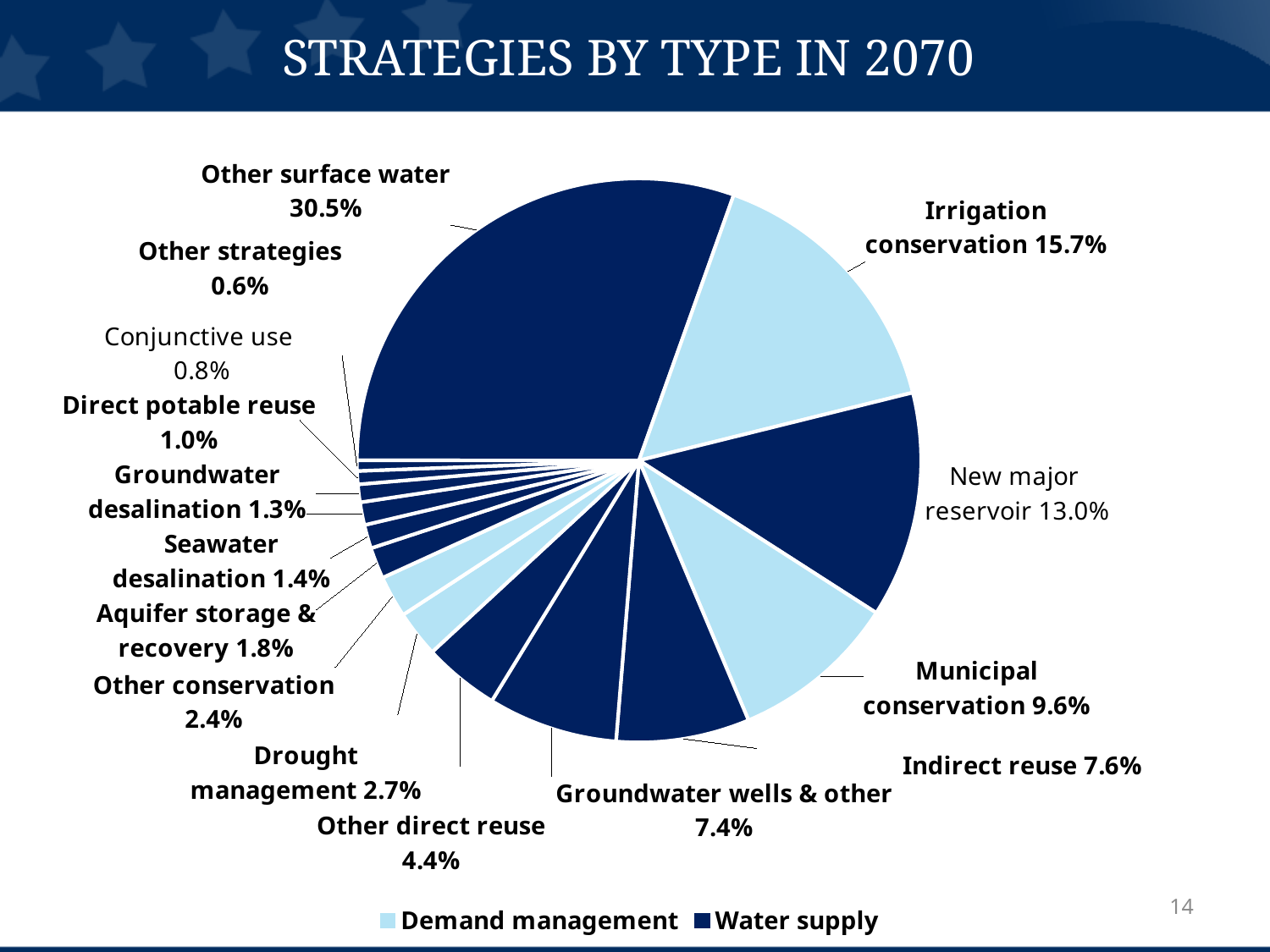
Which strategy type has the smallest slice of the pie? Other strategies What is the value shown for Irrigation conservation? 15.7% What is the title of the chart on the slide? STRATEGIES BY TYPE IN 2070 What percentage is shown for New major reservoir? 13.0% Which is larger, Drought management or Other conservation? Drought management What is the value for Groundwater wells & other? 7.4% How many entries does the legend list? 2 What is the difference between Municipal conservation and Indirect reuse? 2.0% How many slices does the pie chart have? 15 Which strategy type has the largest slice of the pie? Other surface water What kind of chart is shown on the slide? Pie chart What share of the pie does Other surface water represent? 30.5%